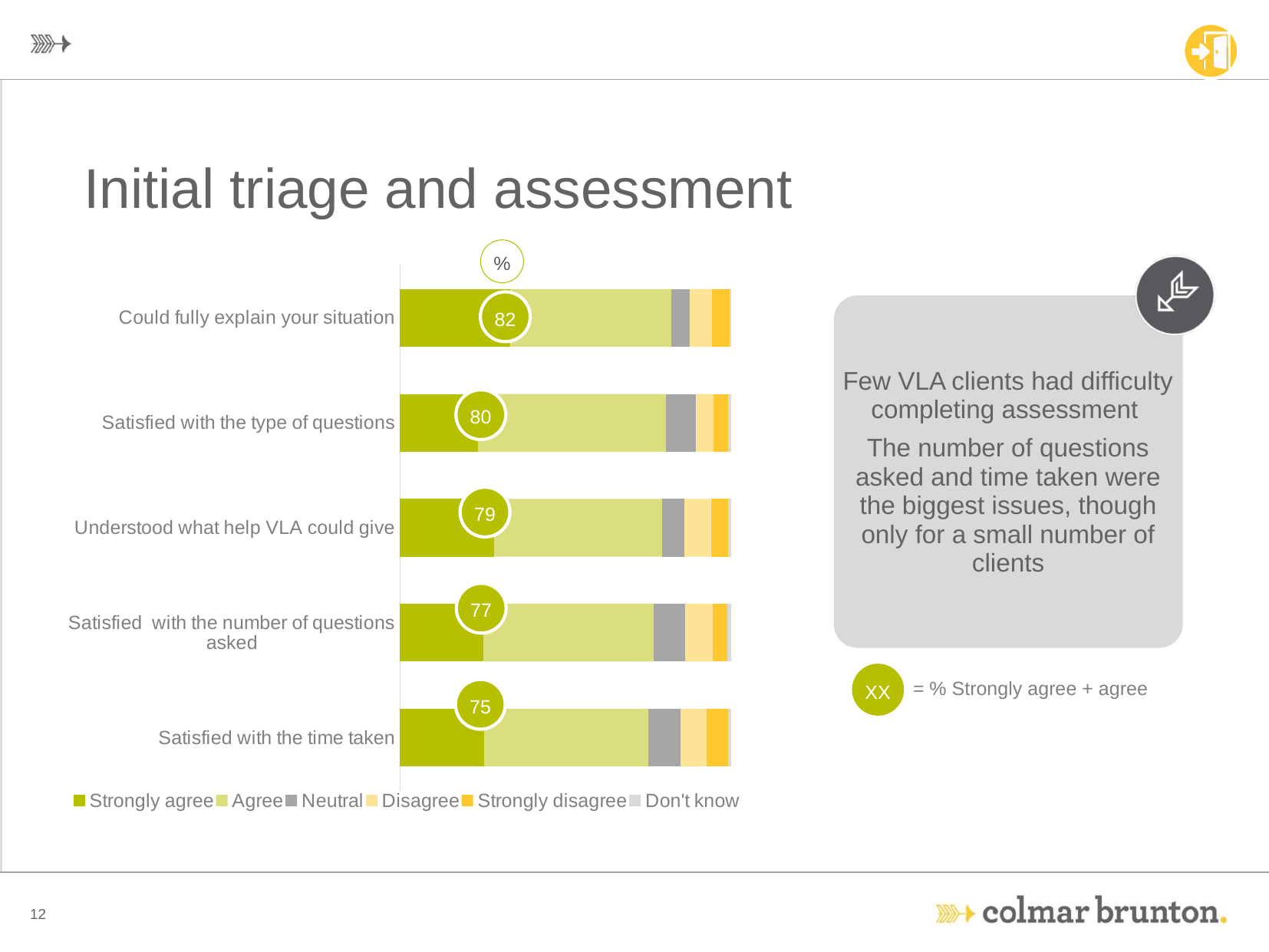
Which statement has the highest combined strongly agree plus agree percentage? Could fully explain your situation How many response categories does the legend list? 6 What is the combined percentage of strongly agree and agree for "Could fully explain your situation"? 82 What is the difference between the combined agreement values for "Satisfied with the type of questions" and "Satisfied with the number of questions asked"? 3 What type of chart is shown on the slide? Stacked bar chart Which legend entry is shown in the darkest green colour? Strongly agree How many statements are plotted in the chart? 5 According to the key on the slide, what do the circled numbers on the bars represent? % Strongly agree + agree Which statement has the lowest combined strongly agree plus agree percentage? Satisfied with the time taken What combined strongly agree plus agree value is shown for "Understood what help VLA could give"? 79 Which has a higher combined agreement value: "Understood what help VLA could give" or "Satisfied with the time taken"? Understood what help VLA could give What is the combined strongly agree plus agree value shown for "Satisfied with the time taken"? 75